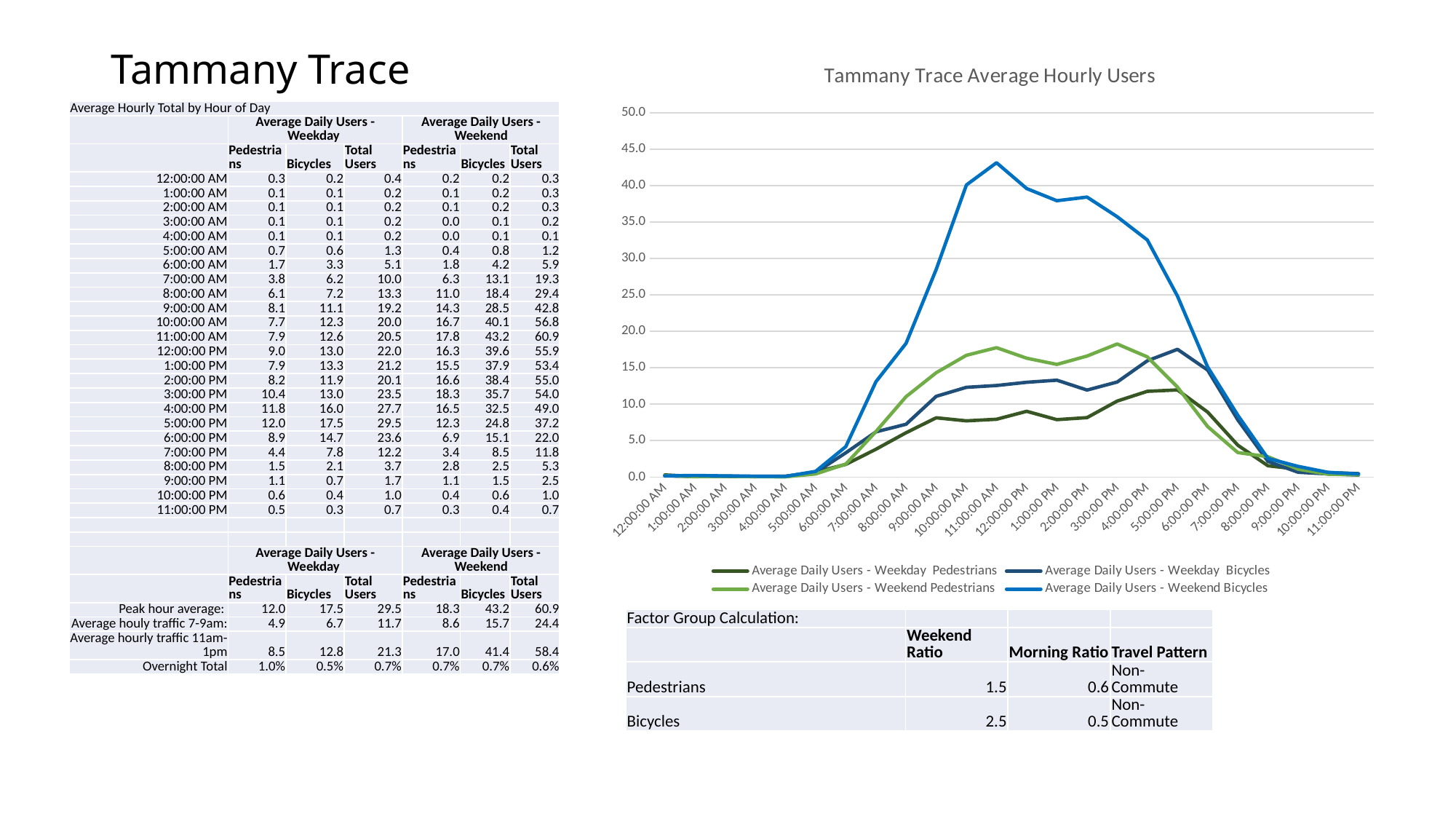
How many hourly points are plotted along the x axis of the 'Tammany Trace Average Hourly Users' chart? 24 How many series does the legend of the 'Tammany Trace Average Hourly Users' chart list? 4 What kind of chart is 'Tammany Trace Average Hourly Users'? Line chart What is the title of the line chart on the slide? Tammany Trace Average Hourly Users In the 'Tammany Trace Average Hourly Users' chart, which series reaches the highest value? Average Daily Users - Weekend Bicycles In the 'Tammany Trace Average Hourly Users' chart, is the value for Weekend Bicycles at 11:00:00 AM greater or less than 40.0? greater In the 'Tammany Trace Average Hourly Users' chart, does the Weekend Bicycles series rise or fall between 11:00:00 AM and 6:00:00 PM? Fall In the 'Tammany Trace Average Hourly Users' chart, is the value for Weekday Pedestrians at 5:00:00 PM greater or less than 15.0? less What is the peak value of the Weekend Bicycles series in the 'Tammany Trace Average Hourly Users' chart, as printed in the table on the slide? 43.2 In the 'Tammany Trace Average Hourly Users' chart, at 3:00:00 PM which is larger: Weekend Pedestrians or Weekday Bicycles? Weekend Pedestrians In the 'Tammany Trace Average Hourly Users' chart, is the value for Weekday Bicycles at 5:00:00 PM greater or less than 15.0? greater Using the peak hour averages printed in the table, what is the difference between the Weekend Bicycles peak and the Weekday Bicycles peak? 25.7